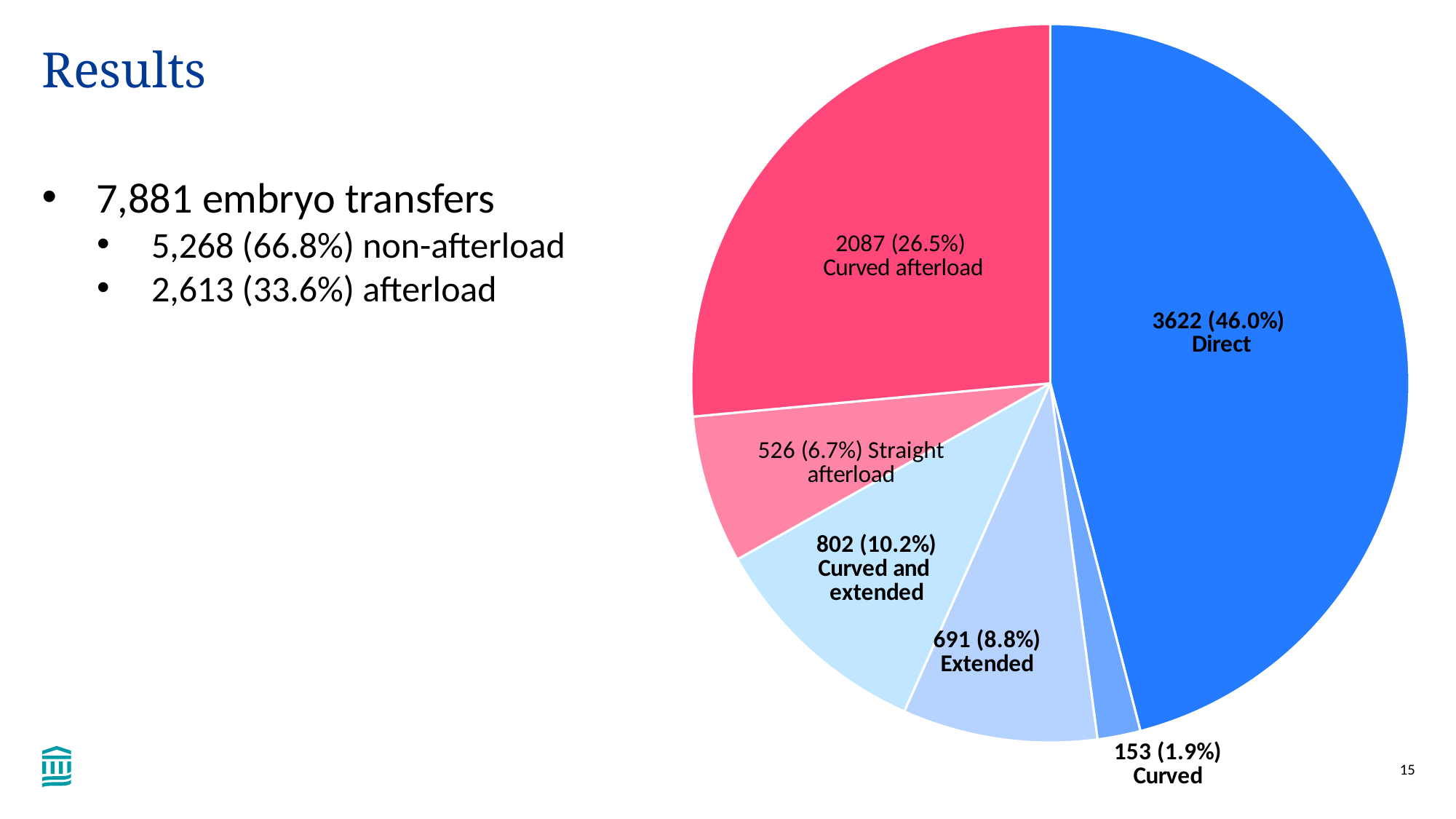
Which slice is the smallest in the pie chart? Curved What is the combined count of the Direct and Curved afterload slices? 5709 What kind of chart is shown on the slide? pie chart Which slice has a larger count, Extended or Straight afterload? Extended What colour is the Curved afterload slice? pink/red What percentage share does the Curved afterload slice have? 26.5% What is the difference in count between the Curved and extended slice and the Extended slice? 111 What is the count shown for the Direct slice? 3622 Which slice is the largest in the pie chart? Direct What is the count shown for the Straight afterload slice? 526 How many slices does the pie chart have? 6 What percentage share does the Curved slice have? 1.9%